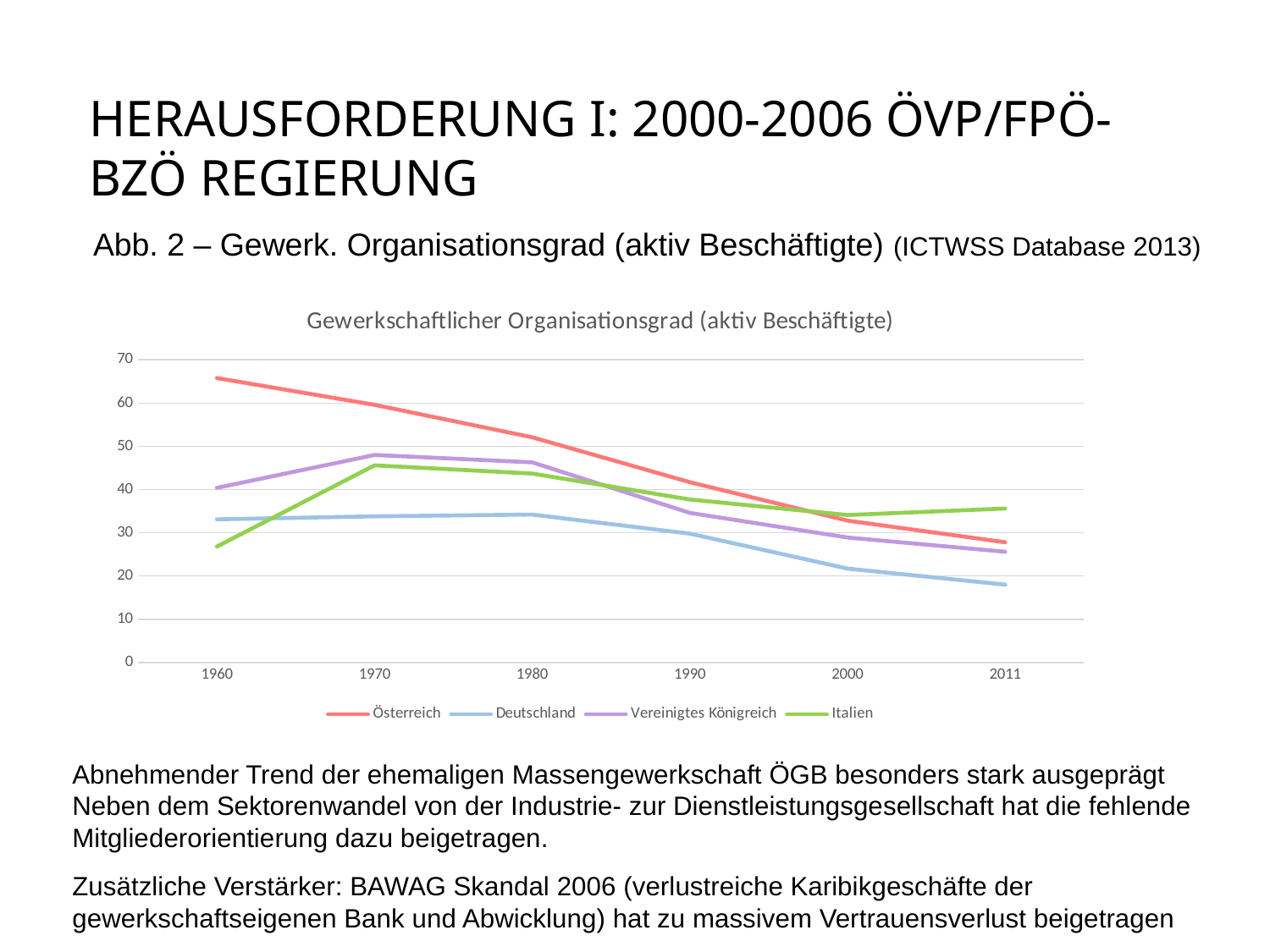
Is the value for Italien in 1960 greater or less than 30? less How many series does the legend list? 4 Does the value for Österreich rise or fall from 1960 to 2011? fall What is the title of the chart? Gewerkschaftlicher Organisationsgrad (aktiv Beschäftigte) What kind of chart is shown on the slide? line chart Is the value for Österreich in 1960 greater or less than 60? greater Which country has the lowest value in 2011? Deutschland How many years are shown on the x axis? 6 Which country has the highest value in 2011? Italien Which country has the lowest value in 1960? Italien Is the value for Vereinigtes Königreich in 1970 greater or less than 40? greater Which country has the highest value in 1960? Österreich